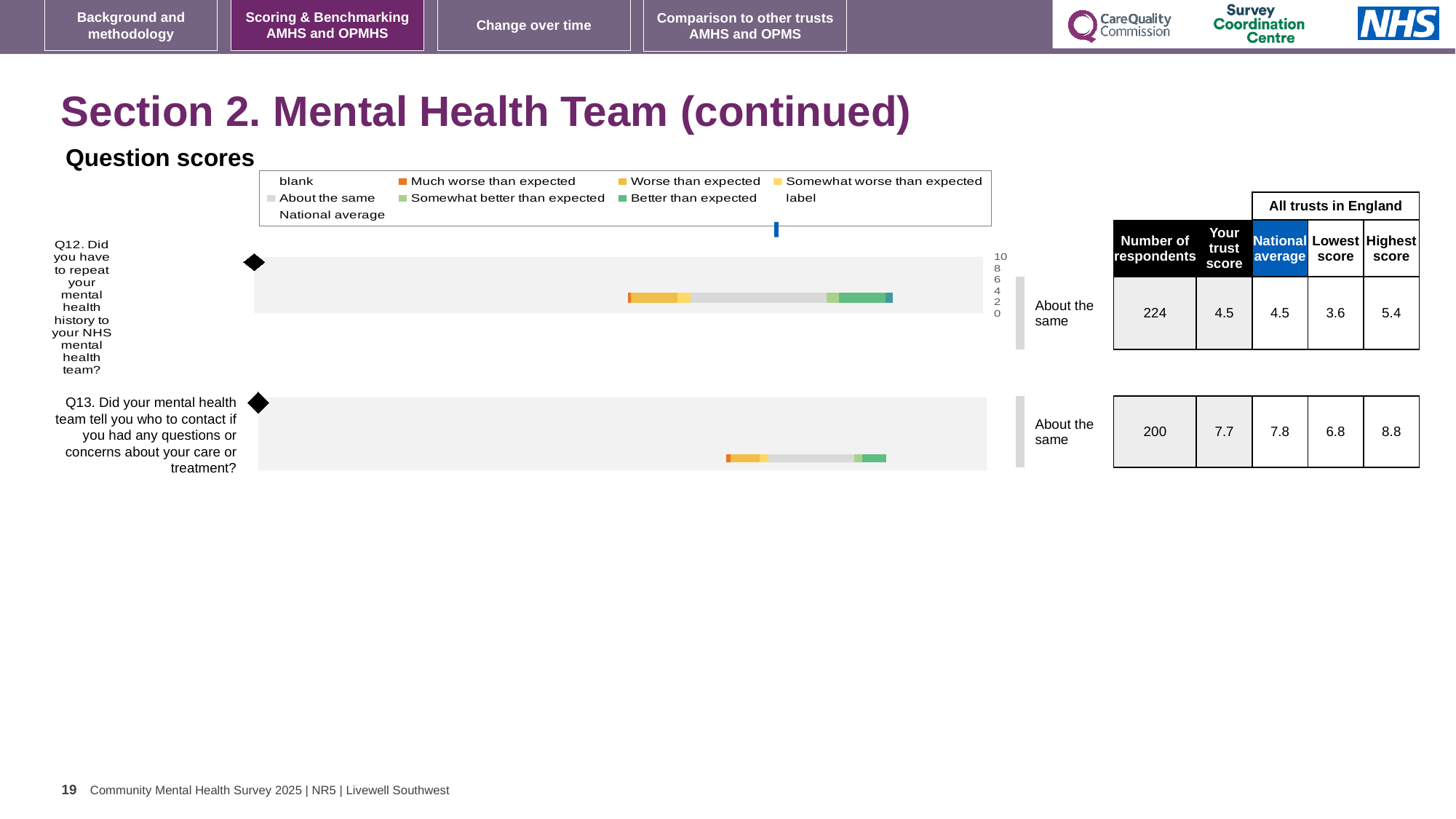
For Q12 (repeating mental health history), how many respondents were there? 224 For Q12 (repeating mental health history), what is the difference between the highest score and the lowest score among all trusts in England? 1.8 For Q13 (who to contact with questions or concerns), which is larger: the trust's score or the national average? national average For Q13 (who to contact with questions or concerns), what is the highest score among all trusts in England? 8.8 What benchmark category is shown for Q13 (who to contact with questions or concerns)? About the same For Q12 (repeating mental health history), what is the national average score? 4.5 For Q12 (repeating mental health history), what is the trust's score? 4.5 How many entries does the legend above the charts list? 9 What colour represents 'Much worse than expected' in the legend? orange What kind of chart is used to show the Q12 question score? bar chart For Q13 (who to contact with questions or concerns), what is the trust's score? 7.7 What is the highest tick shown on the score axis next to the Q12 chart? 10